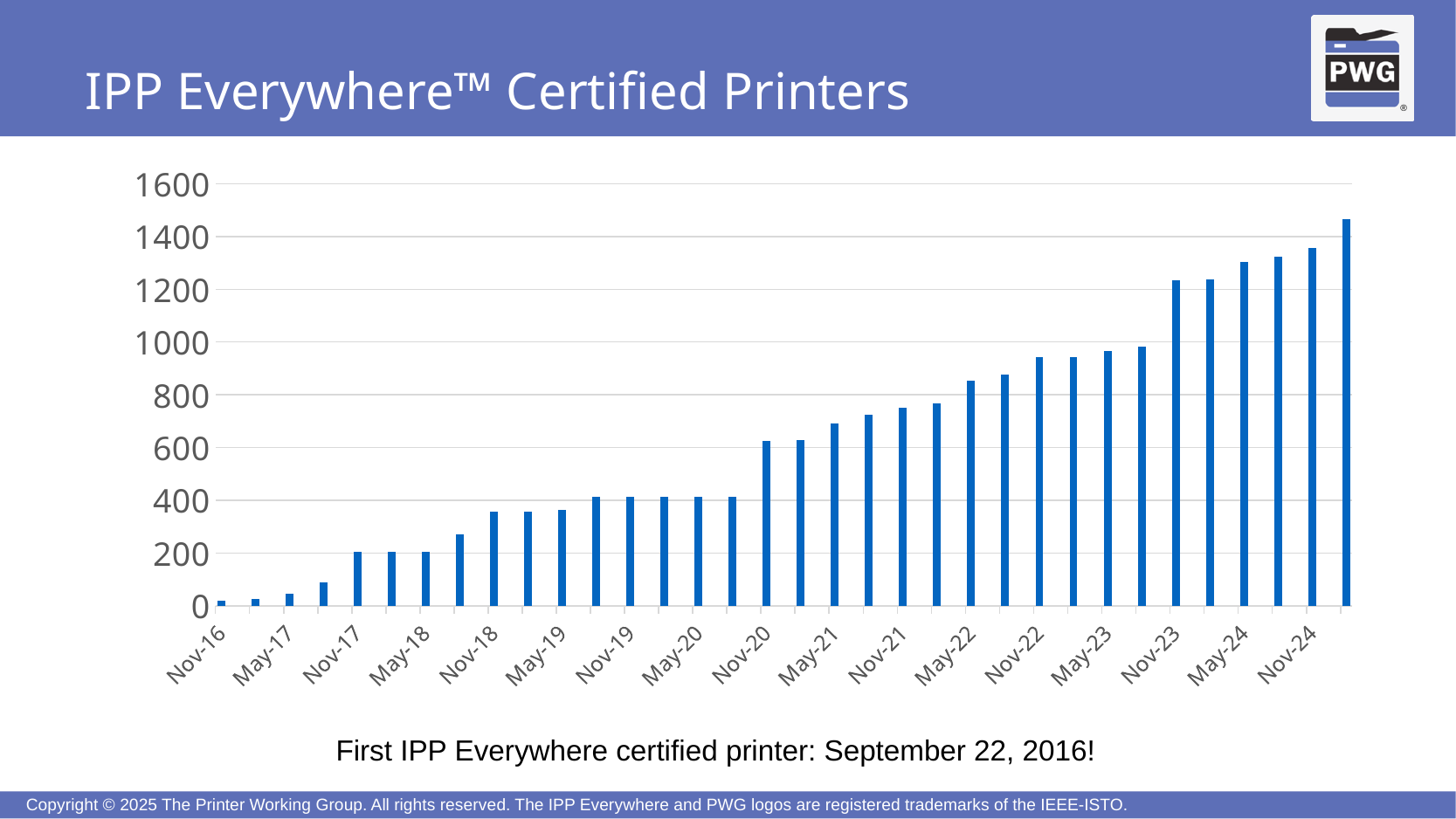
What is the highest value shown on the vertical axis? 1600 Is the value for Nov-22 greater or less than 1000? less Which is larger, the value for Nov-18 or the value for Nov-21? Nov-21 Is the value for May-19 greater or less than 400? less Is the value for May-21 greater or less than 800? less What kind of chart is shown on the slide? bar chart Do the values generally rise or fall from Nov-16 to Nov-24? rise Which labeled category has the lowest value? Nov-16 What is the title of the slide containing the chart? IPP Everywhere™ Certified Printers